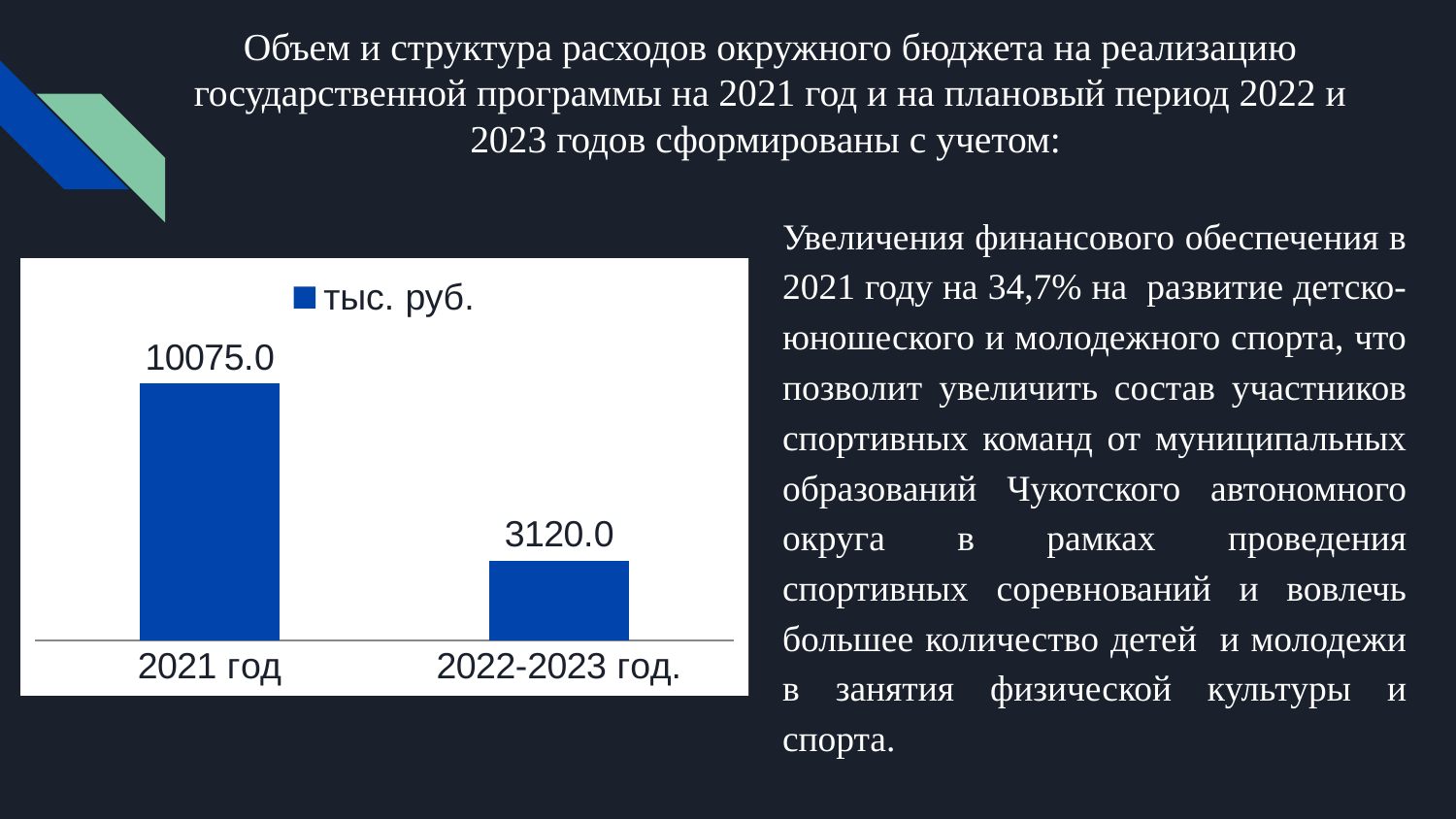
What is the value for 2022-2023 год.? 3120.0 Do the values rise or fall from 2021 год to 2022-2023 год.? fall Which category has the highest value? 2021 год What is the value for 2021 год? 10075.0 What is the name of the series shown in the legend? тыс. руб. Which category has the lowest value? 2022-2023 год. How many categories are shown on the chart? 2 What colour are the bars in the chart? blue What is the difference between the values for 2021 год and 2022-2023 год.? 6955.0 Which is larger, the value for 2021 год or the value for 2022-2023 год.? 2021 год How many series does the legend list? 1 What kind of chart is shown on the slide? bar chart